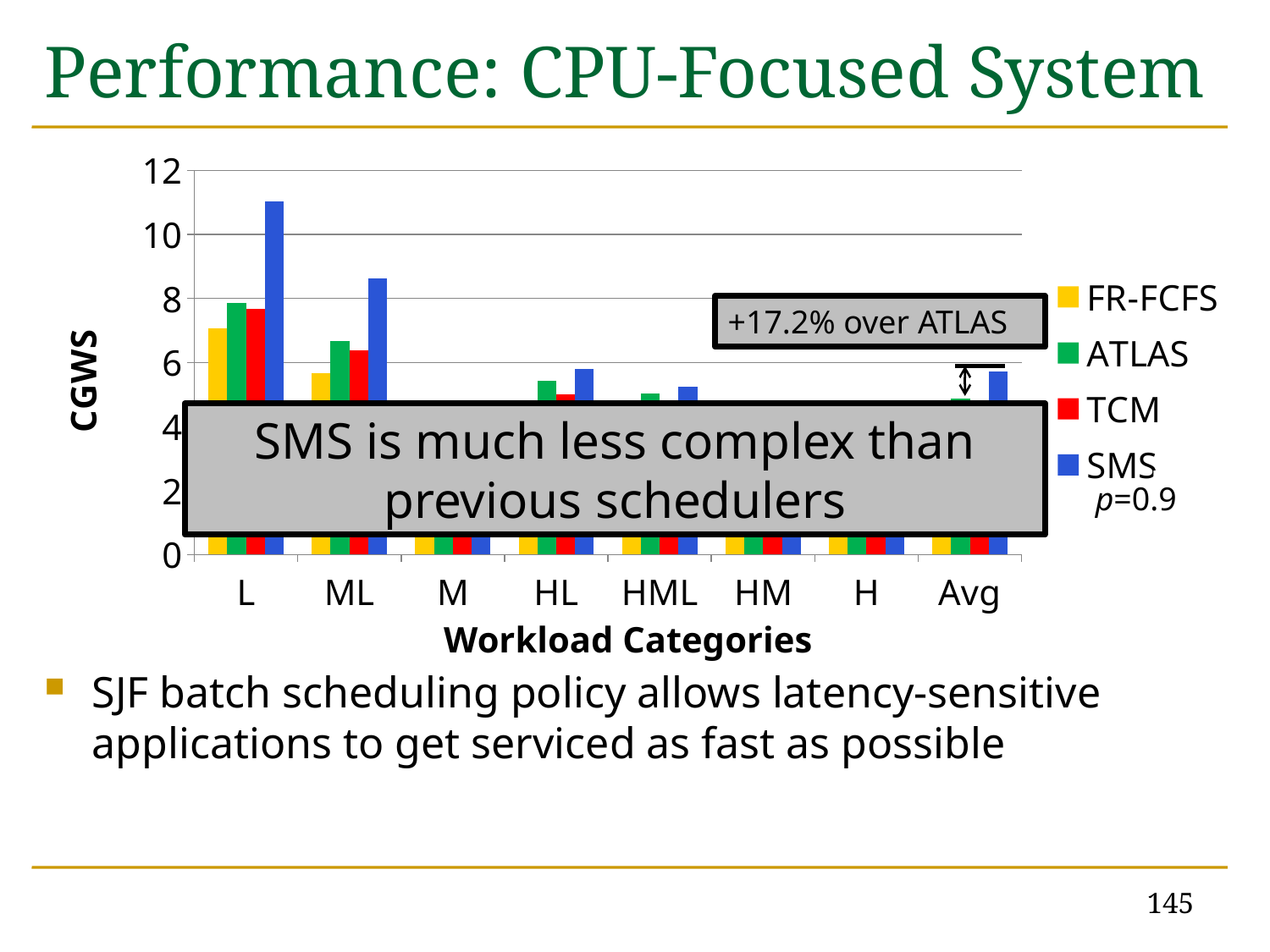
In which workload category does SMS reach its highest value? L Is the FR-FCFS value for the L category greater or less than 8? less What improvement does the annotation on the chart state for SMS over ATLAS? +17.2% over ATLAS Is the SMS value for the ML category greater or less than 8? greater How many workload categories are shown on the x axis? 8 What kind of chart is shown on the slide? bar chart Which is larger for the ML category, the SMS value or the TCM value? SMS Which series has the highest value for the L workload category? SMS What is the label of the y axis? CGWS Is the SMS value for the L category greater or less than 10? greater Which is larger for the L category, the FR-FCFS value or the SMS value? SMS How many series does the legend list? 4